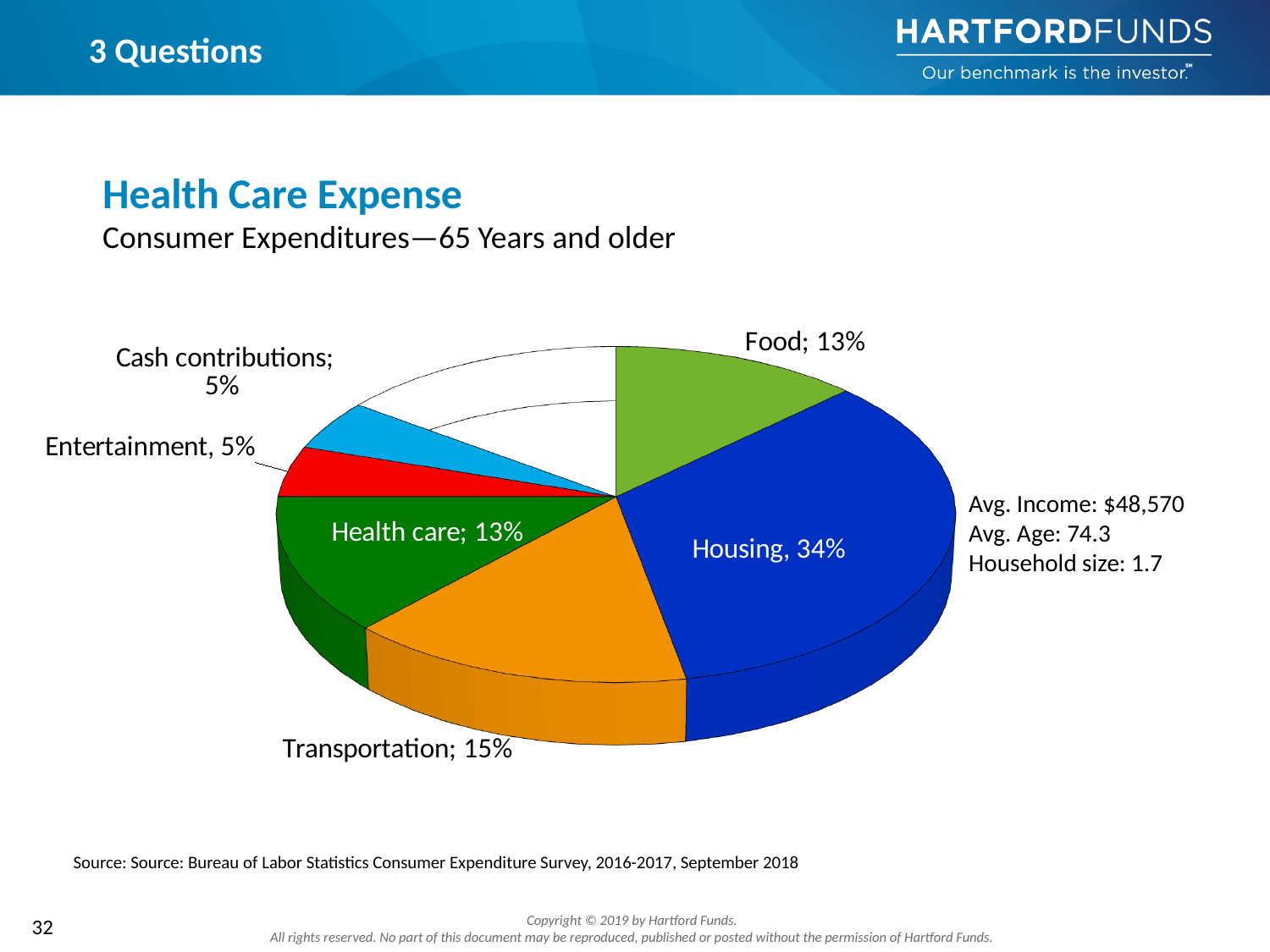
What share of consumer expenditures goes to Transportation? 15% What share of consumer expenditures goes to Housing? 34% What is the difference in percentage points between the Food share and the Entertainment share? 8 What share of consumer expenditures goes to Entertainment? 5% What share of consumer expenditures goes to Food? 13% What share of consumer expenditures goes to Cash contributions? 5% What is the difference in percentage points between the Housing share and the Transportation share? 19 Which labeled category has the largest share of the pie? Housing What kind of chart is shown on the slide? pie chart Which is larger, the share for Transportation or the share for Health care? Transportation What is the subtitle of the chart below the heading 'Health Care Expense'? Consumer Expenditures—65 Years and older What share of consumer expenditures goes to Health care? 13%